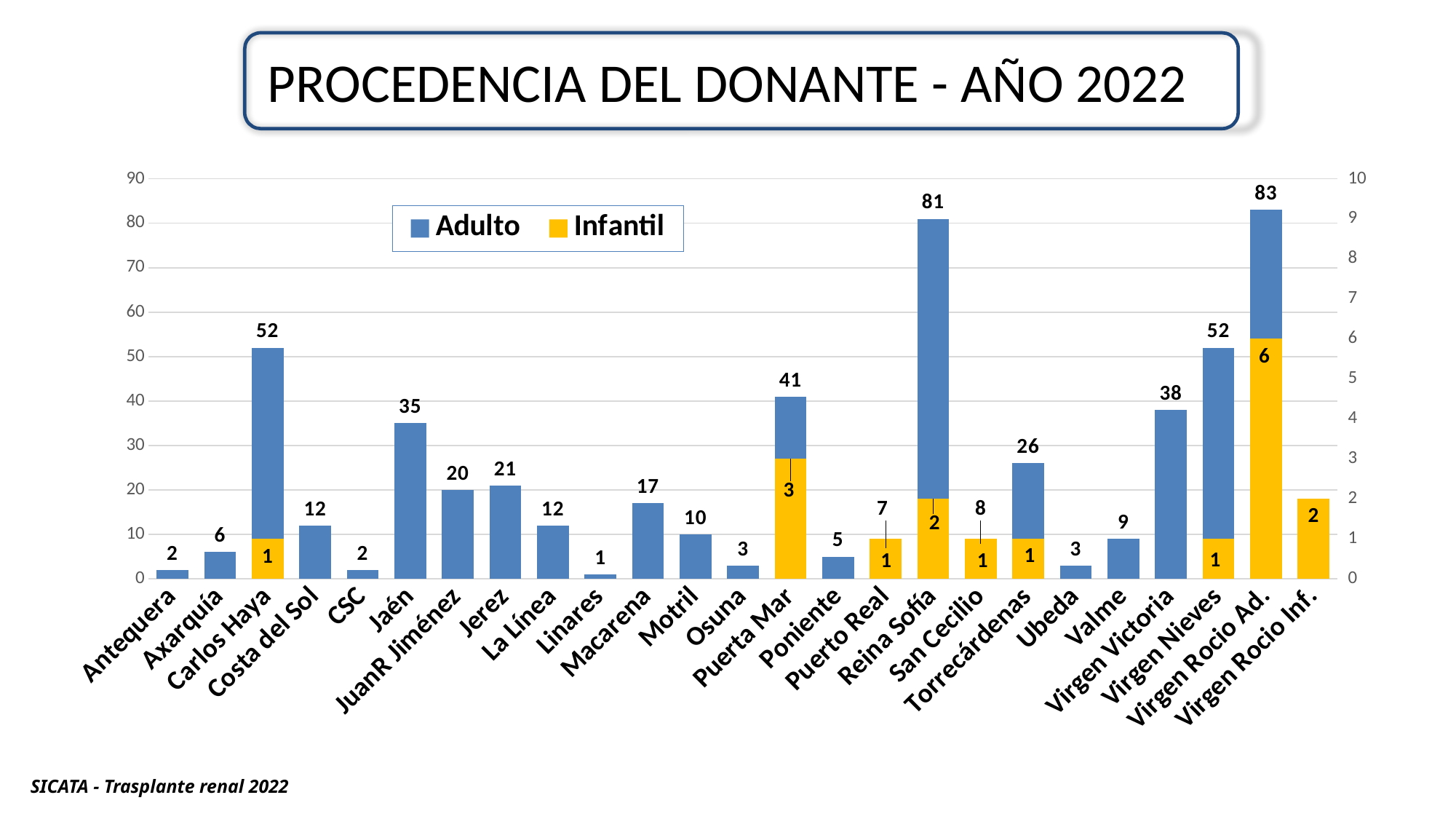
How many categories are shown on the x axis? 25 What kind of chart is shown on the slide? Stacked bar chart What is the difference between the Adulto values for Virgen Rocio Ad. and Reina Sofía? 2 What is the Infantil value for Puerta Mar? 3 How many series does the legend list? 2 Which category has the highest Adulto value? Virgen Rocio Ad. What is the Infantil value for Virgen Rocio Ad.? 6 Which category has the lowest Adulto value? Linares What is the Adulto value for Reina Sofía? 81 What is the Adulto value for Jaén? 35 Which category has the highest Infantil value? Virgen Rocio Ad. Which has a larger Adulto value, Carlos Haya or Virgen Victoria? Carlos Haya